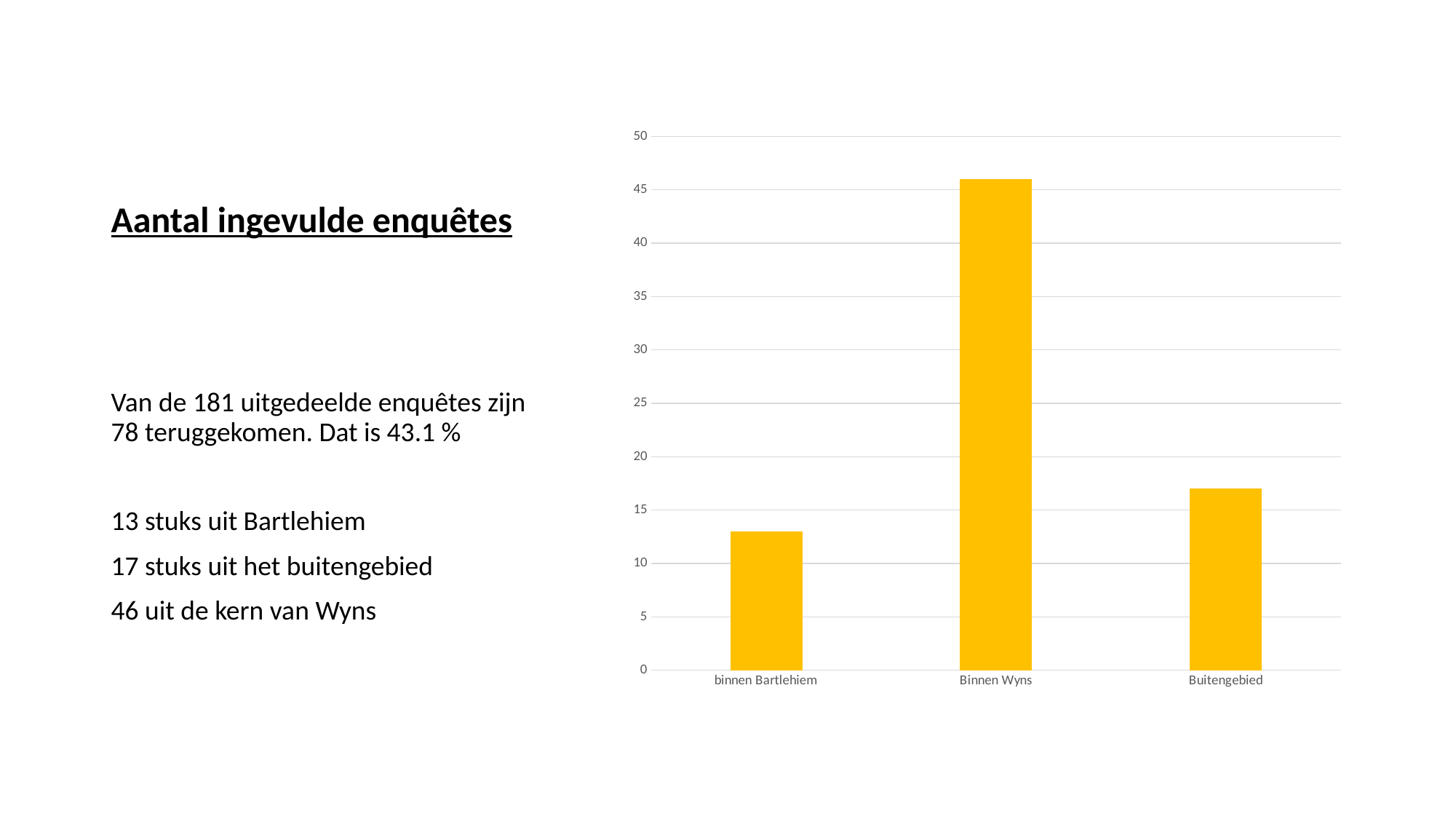
What colour are the bars in the chart? yellow How many categories are shown on the x axis of the chart? 3 According to the slide, how many surveys came from binnen Bartlehiem? 13 What kind of chart is shown on the slide? bar chart Which is larger, the value for Buitengebied or the value for binnen Bartlehiem? Buitengebied Which category has the highest bar in the chart? Binnen Wyns What is the difference between the number of surveys from Binnen Wyns and from Buitengebied, using the values stated on the slide? 29 According to the slide, how many surveys came from Binnen Wyns? 46 Is the value for Binnen Wyns greater or less than 40? greater Is the value for Buitengebied greater or less than 20? less Is the value for binnen Bartlehiem greater or less than 15? less Which category has the lowest bar in the chart? binnen Bartlehiem